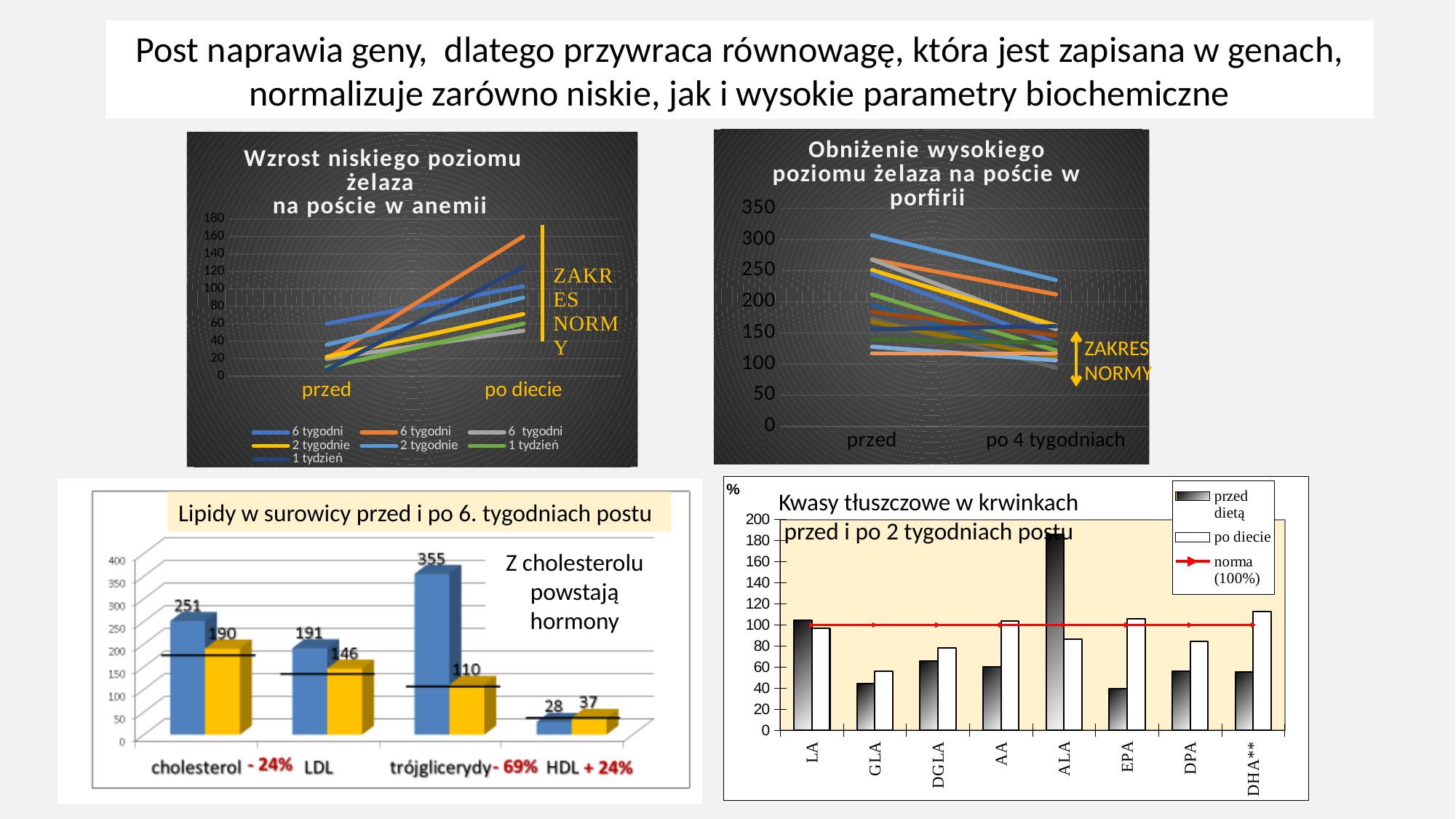
In the chart 'Lipidy w surowicy przed i po 6. tygodniach postu', what is the cholesterol value before fasting (blue bar)? 251 In the chart 'Lipidy w surowicy przed i po 6. tygodniach postu', by how much did cholesterol drop from before (251) to after (190)? 61 In the chart 'Lipidy w surowicy przed i po 6. tygodniach postu', which category has the highest value before fasting? trójglicerydy In the chart 'Kwasy tłuszczowe w krwinkach przed i po 2 tygodniach postu', is the 'przed dietą' value for ALA greater or less than 160? greater In the chart 'Obniżenie wysokiego poziomu żelaza na poście w porfirii', do the lines rise or fall from 'przed' to 'po 4 tygodniach'? fall In the chart 'Lipidy w surowicy przed i po 6. tygodniach postu', which category has the lowest value before fasting? HDL In the chart 'Lipidy w surowicy przed i po 6. tygodniach postu', what is the trójglicerydy value after fasting (yellow bar)? 110 How many series does the legend of the chart 'Wzrost niskiego poziomu żelaza na poście w anemii' list? 7 How many entries does the legend of the chart 'Kwasy tłuszczowe w krwinkach przed i po 2 tygodniach postu' list? 3 How many categories are shown on the x axis of the chart 'Kwasy tłuszczowe w krwinkach przed i po 2 tygodniach postu'? 8 In the chart 'Lipidy w surowicy przed i po 6. tygodniach postu', is the HDL value larger before or after fasting? after (37) How many categories are shown in the chart 'Lipidy w surowicy przed i po 6. tygodniach postu'? 4